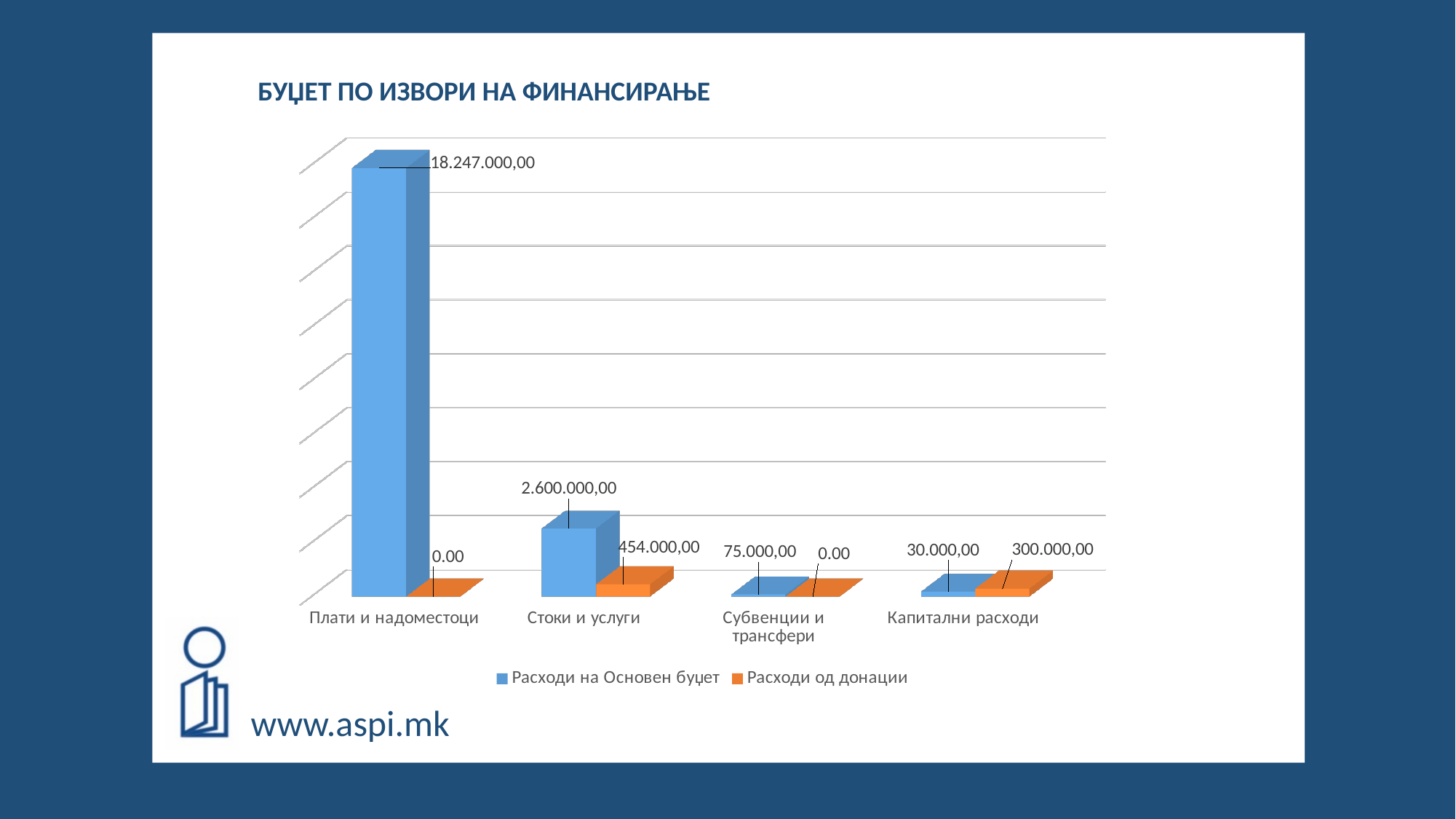
What is the value of Расходи од донации for Капитални расходи? 300.000,00 What is the value of Расходи на Основен буџет for Плати и надоместоци? 18.247.000,00 What is the difference between Расходи на Основен буџет for Плати и надоместоци and for Стоки и услуги? 15.647.000,00 Which category has the highest value for Расходи на Основен буџет? Плати и надоместоци What is the value of Расходи од донации for Стоки и услуги? 454.000,00 How many categories are shown on the x axis? 4 How many series does the legend list? 2 For Капитални расходи, which is larger: Расходи на Основен буџет or Расходи од донации? Расходи од донации Which category has the highest value for Расходи од донации? Стоки и услуги What kind of chart is shown on the slide? Bar chart What is the value of Расходи на Основен буџет for Субвенции и трансфери? 75.000,00